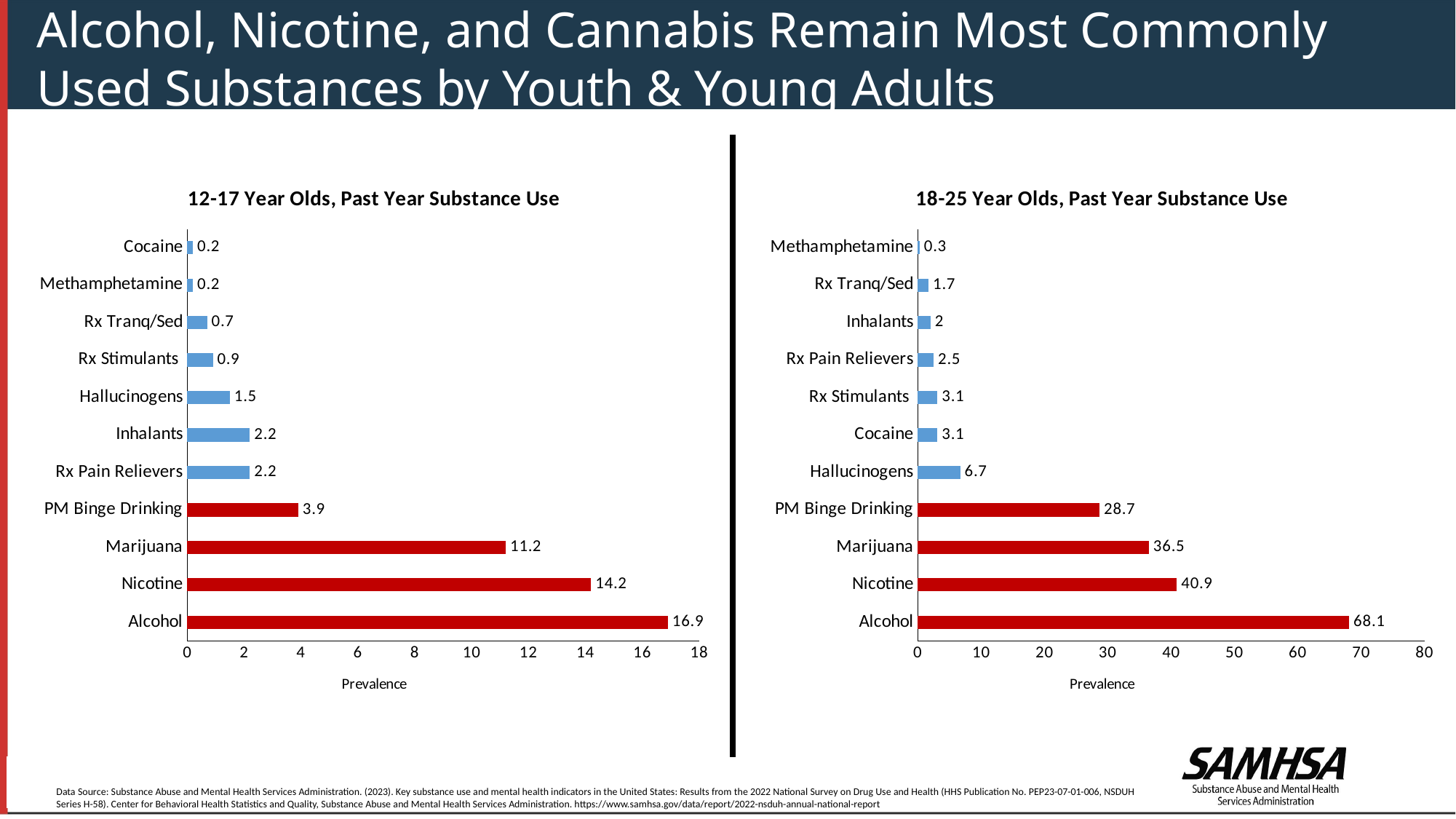
In the '12-17 Year Olds, Past Year Substance Use' chart, what is the difference between the values for Nicotine and Marijuana? 3 How many categories are shown in the '12-17 Year Olds, Past Year Substance Use' chart? 11 In the '18-25 Year Olds, Past Year Substance Use' chart, which category has the lowest value? Methamphetamine In the '18-25 Year Olds, Past Year Substance Use' chart, what is the value for PM Binge Drinking? 28.7 What kind of chart is the '18-25 Year Olds, Past Year Substance Use' chart? Bar chart What is the x-axis label of the '12-17 Year Olds, Past Year Substance Use' chart? Prevalence In the '12-17 Year Olds, Past Year Substance Use' chart, which category has the highest value? Alcohol In the '18-25 Year Olds, Past Year Substance Use' chart, what is the value for Hallucinogens? 6.7 In the '18-25 Year Olds, Past Year Substance Use' chart, is the value for Marijuana greater or less than 30? greater In the '12-17 Year Olds, Past Year Substance Use' chart, what is the value for Marijuana? 11.2 In the '18-25 Year Olds, Past Year Substance Use' chart, what is the difference between the values for Alcohol and Nicotine? 27.2 In the '12-17 Year Olds, Past Year Substance Use' chart, which is larger, the value for PM Binge Drinking or the value for Hallucinogens? PM Binge Drinking